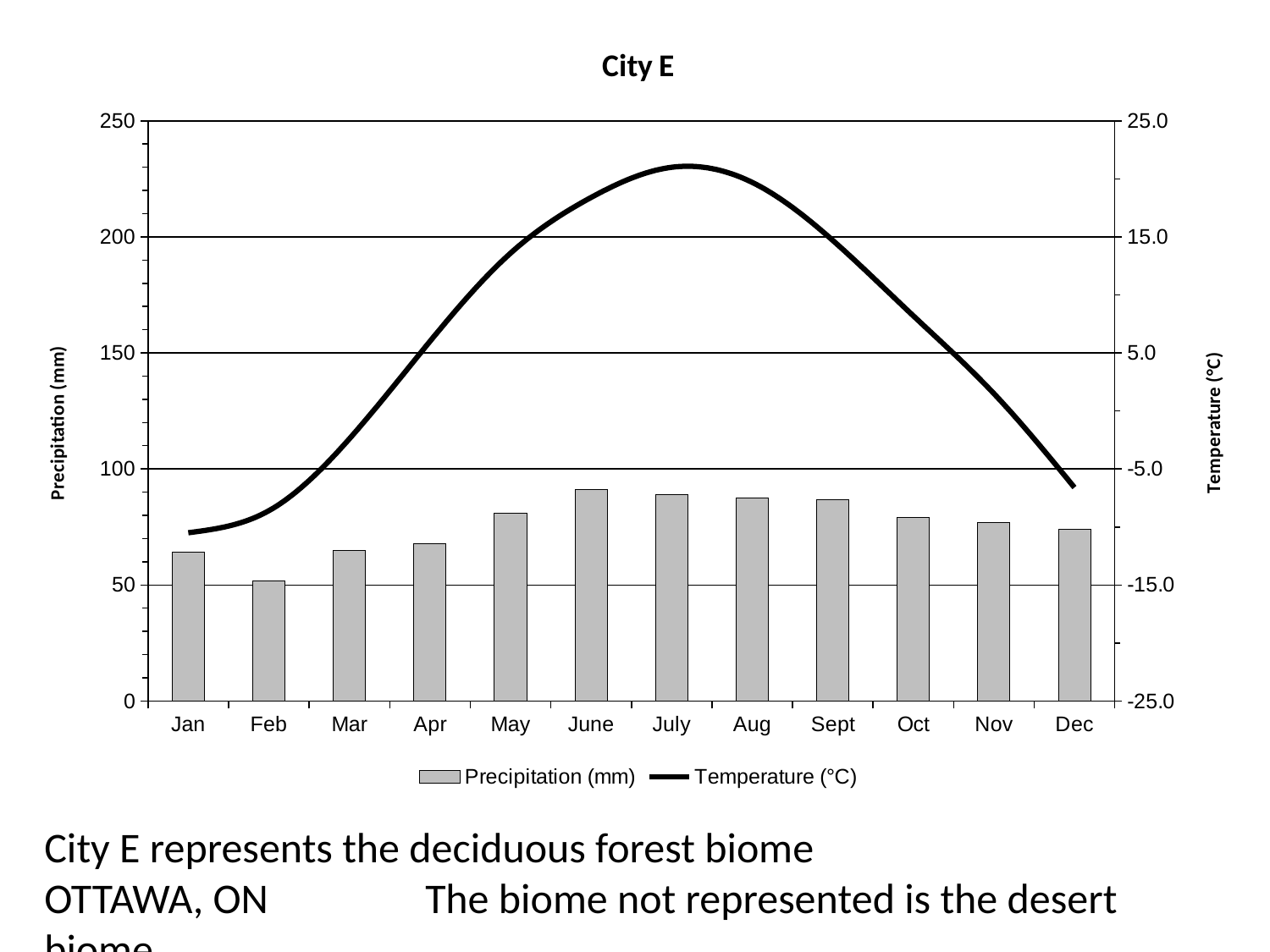
Is the temperature for Jan greater or less than -5.0? less In which month is the temperature lowest? Jan Which month has the lowest precipitation? Feb How many series does the legend of the City E chart list? 2 In which month is the temperature highest? July Does the temperature rise or fall from Jan to July? rise Which series is drawn as a line in the City E chart? Temperature (°C) What kind of chart is shown on the slide? A combined bar and line chart What is the title of the chart? City E How many months are shown on the x axis of the City E chart? 12 Is the temperature for July greater or less than 15.0? greater Is the precipitation for Jan greater or less than 50? greater